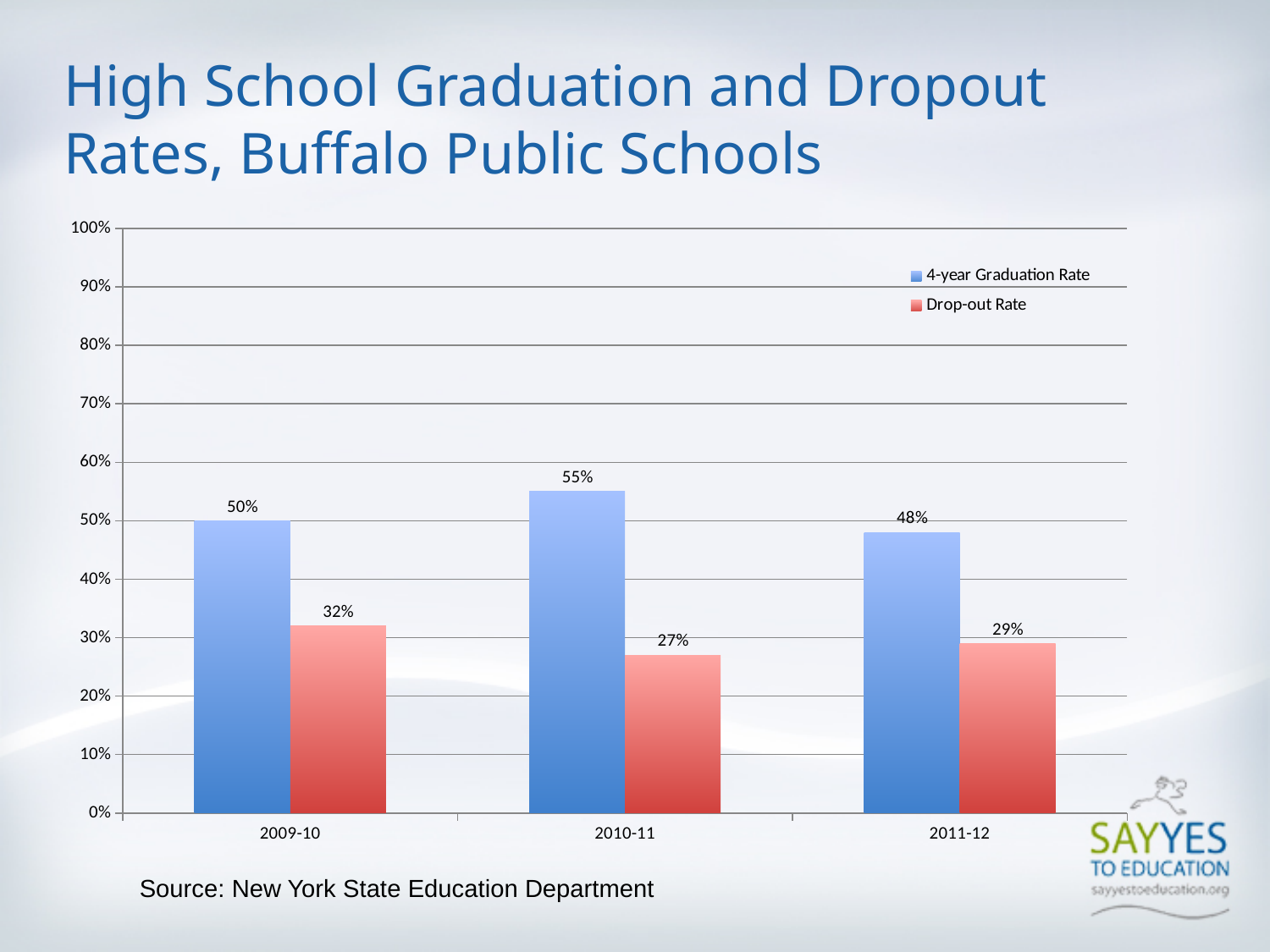
Which year has the highest 4-year Graduation Rate? 2010-11 What is the difference between the 4-year Graduation Rate and the Drop-out Rate in 2011-12? 19% How many school years are shown on the x axis? 3 Which is larger, the Drop-out Rate in 2009-10 or the Drop-out Rate in 2011-12? 2009-10 How many series does the legend list? 2 What kind of chart is shown on the slide? bar chart What source is cited below the chart? New York State Education Department What is the 4-year Graduation Rate for 2011-12? 48% What is the Drop-out Rate for 2009-10? 32% Which year has the lowest Drop-out Rate? 2010-11 What is the 4-year Graduation Rate for 2010-11? 55% Is the 4-year Graduation Rate for 2009-10 greater or less than 40%? greater